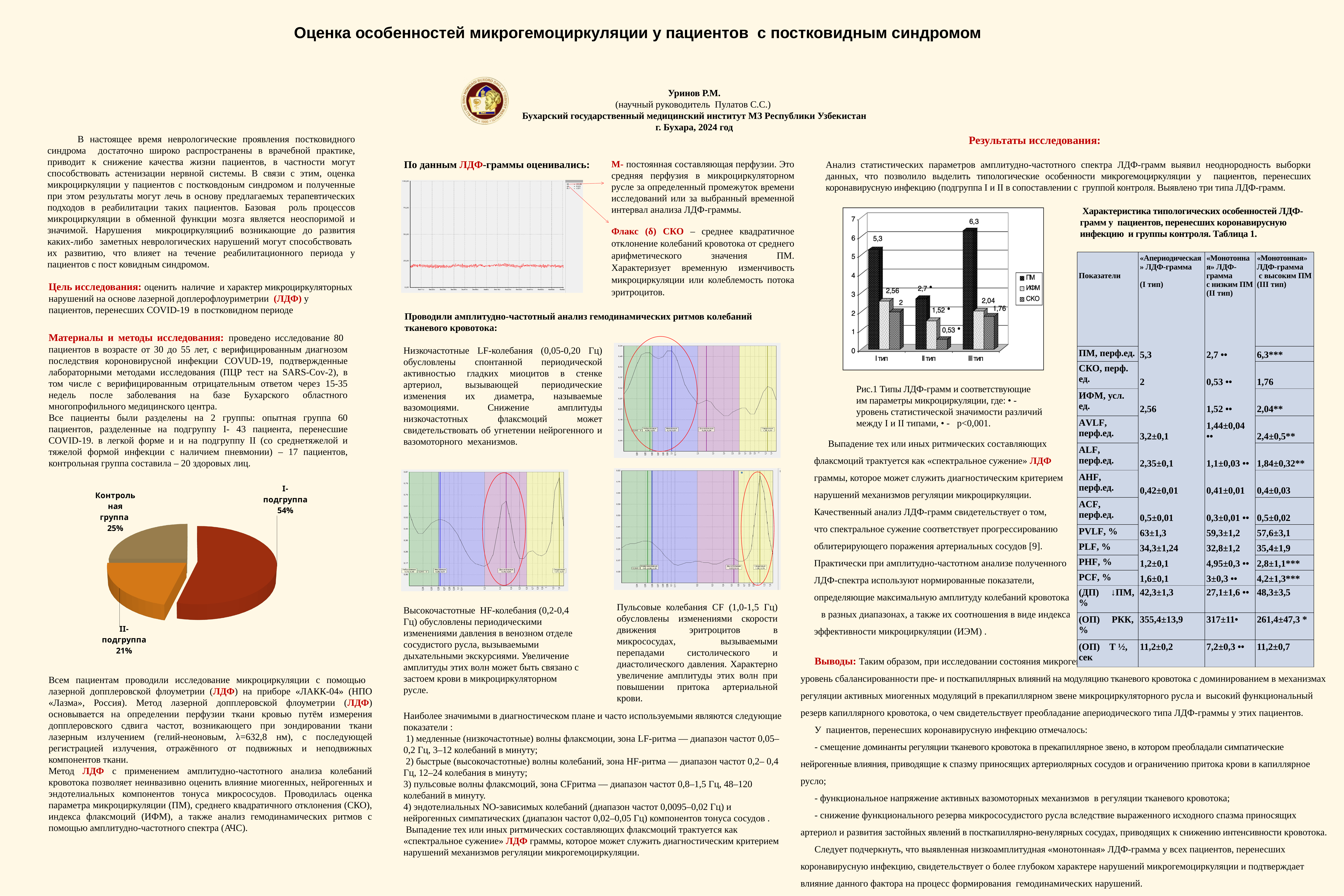
In the bar chart (Рис.1), what is the value of ПМ for III тип? 6,3 In the bar chart (Рис.1), which is larger: ИФМ for II тип or ИФМ for III тип? ИФМ for III тип In the pie chart at the bottom left, what share does the I-подгруппа slice have? 54% What kind of chart is the chart at the bottom left of the slide? Pie chart In the bar chart (Рис.1), how many series does the legend list? 3 In the pie chart at the bottom left, which slice is the smallest? II-подгруппа In the bar chart (Рис.1), what is the value of СКО for II тип? 0,53 In the bar chart (Рис.1), what is the difference between the ПМ values for III тип and I тип? 1,0 In the pie chart at the bottom left, how many slices are there? 3 In the bar chart (Рис.1), what is the value of ИФМ for I тип? 2,56 In the bar chart (Рис.1), which type has the highest ПМ value? III тип In the pie chart at the bottom left, what share does the Контрольная группа slice have? 25%